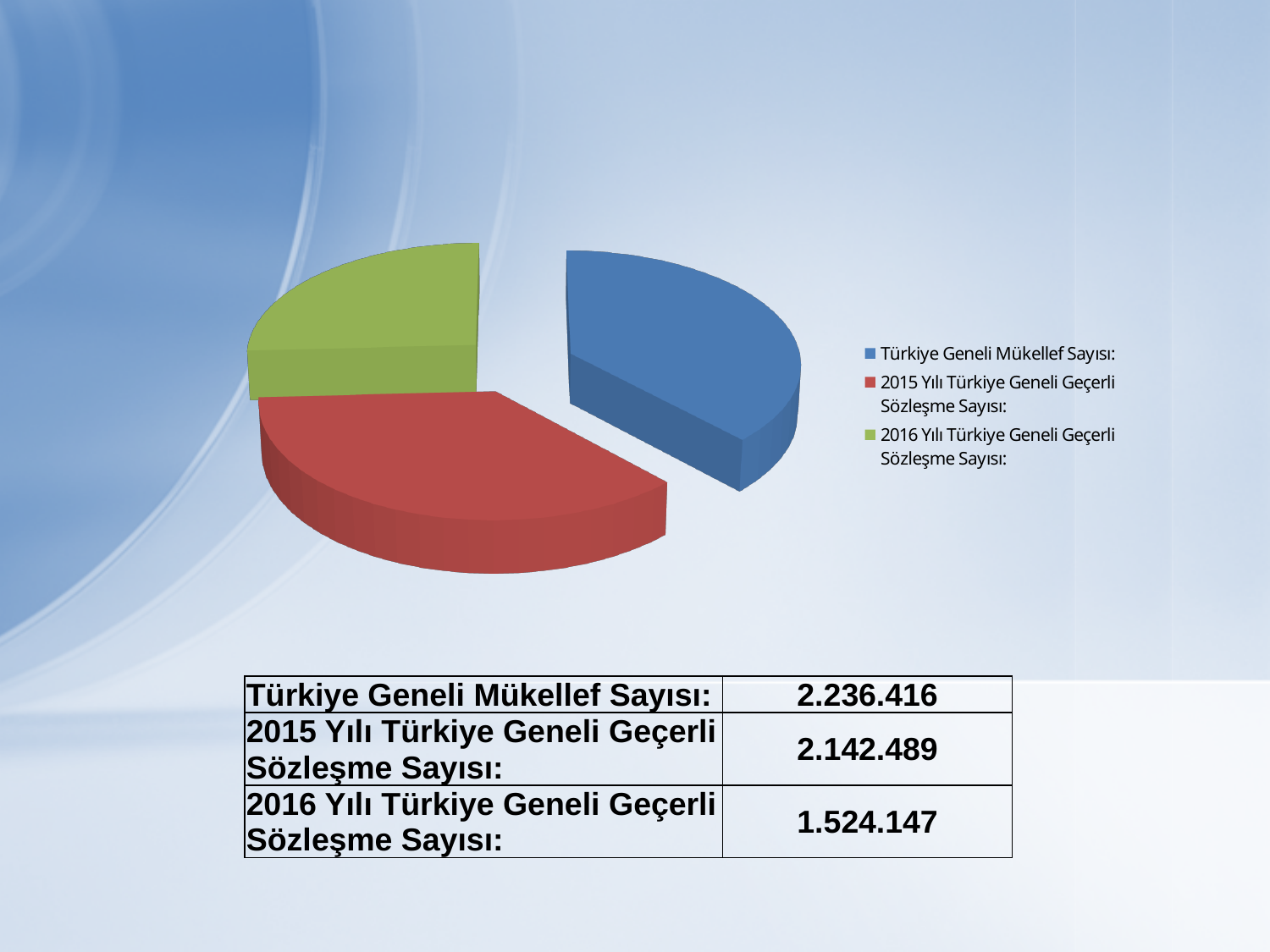
Which colour represents 2016 Yılı Türkiye Geneli Geçerli Sözleşme Sayısı in the pie chart? green What is the difference between the 2015 and 2016 Türkiye Geneli Geçerli Sözleşme Sayısı values? 618.342 What is the difference between Türkiye Geneli Mükellef Sayısı and 2015 Yılı Türkiye Geneli Geçerli Sözleşme Sayısı? 93.927 What is the value for 2015 Yılı Türkiye Geneli Geçerli Sözleşme Sayısı? 2.142.489 Which is larger: the 2015 or the 2016 Türkiye Geneli Geçerli Sözleşme Sayısı? 2015 Which category has the largest value in the pie chart? Türkiye Geneli Mükellef Sayısı How many slices does the pie chart have? 3 How many entries does the legend of the pie chart list? 3 Which category has the smallest value in the pie chart? 2016 Yılı Türkiye Geneli Geçerli Sözleşme Sayısı What kind of chart is shown on the slide? pie chart What is the value for 2016 Yılı Türkiye Geneli Geçerli Sözleşme Sayısı? 1.524.147 What is the value for Türkiye Geneli Mükellef Sayısı? 2.236.416